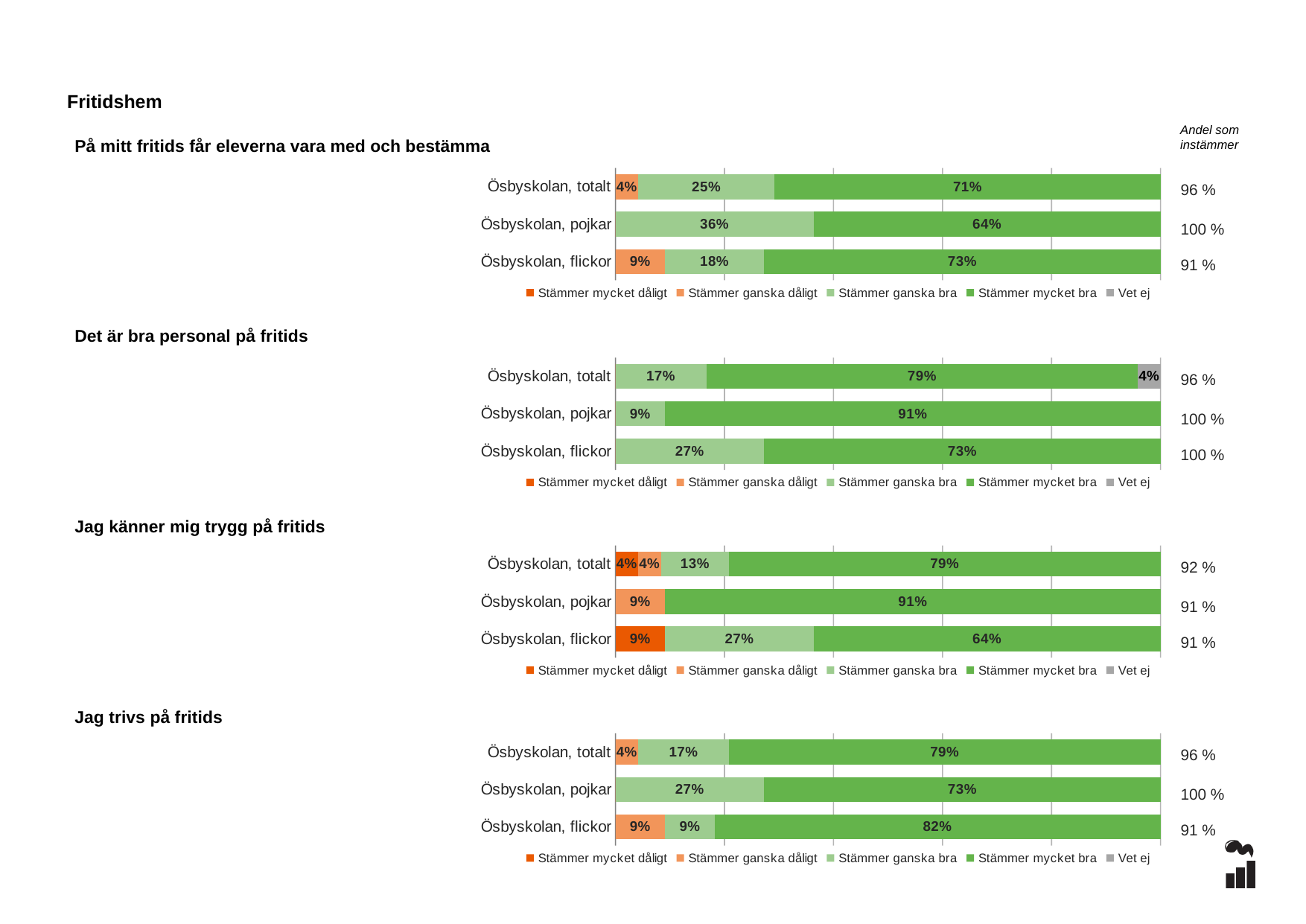
In the chart "Det är bra personal på fritids", what is the "Stämmer mycket bra" value for Ösbyskolan, pojkar? 91% In the chart "Det är bra personal på fritids", what is the difference between the "Stämmer mycket bra" values for Ösbyskolan, pojkar and Ösbyskolan, flickor? 18% In the chart "På mitt fritids får eleverna vara med och bestämma", what is the "Stämmer mycket bra" value for Ösbyskolan, flickor? 73% What kind of chart is "Det är bra personal på fritids"? Stacked bar chart In the chart "Jag trivs på fritids", what is the "Stämmer mycket bra" value for Ösbyskolan, flickor? 82% How many categories are shown in the chart "Jag trivs på fritids"? 3 In the chart "Jag känner mig trygg på fritids", which category has the lowest "Stämmer mycket bra" value? Ösbyskolan, flickor How many series does the legend list in the chart "På mitt fritids får eleverna vara med och bestämma"? 5 In the chart "Det är bra personal på fritids", what is the "Vet ej" value for Ösbyskolan, totalt? 4% In the chart "Jag trivs på fritids", which is larger: the "Stämmer ganska bra" value for Ösbyskolan, pojkar or for Ösbyskolan, totalt? Ösbyskolan, pojkar In the chart "På mitt fritids får eleverna vara med och bestämma", which category has the highest "Stämmer ganska bra" value? Ösbyskolan, pojkar In the chart "Jag känner mig trygg på fritids", what is the "Stämmer mycket dåligt" value for Ösbyskolan, flickor? 9%